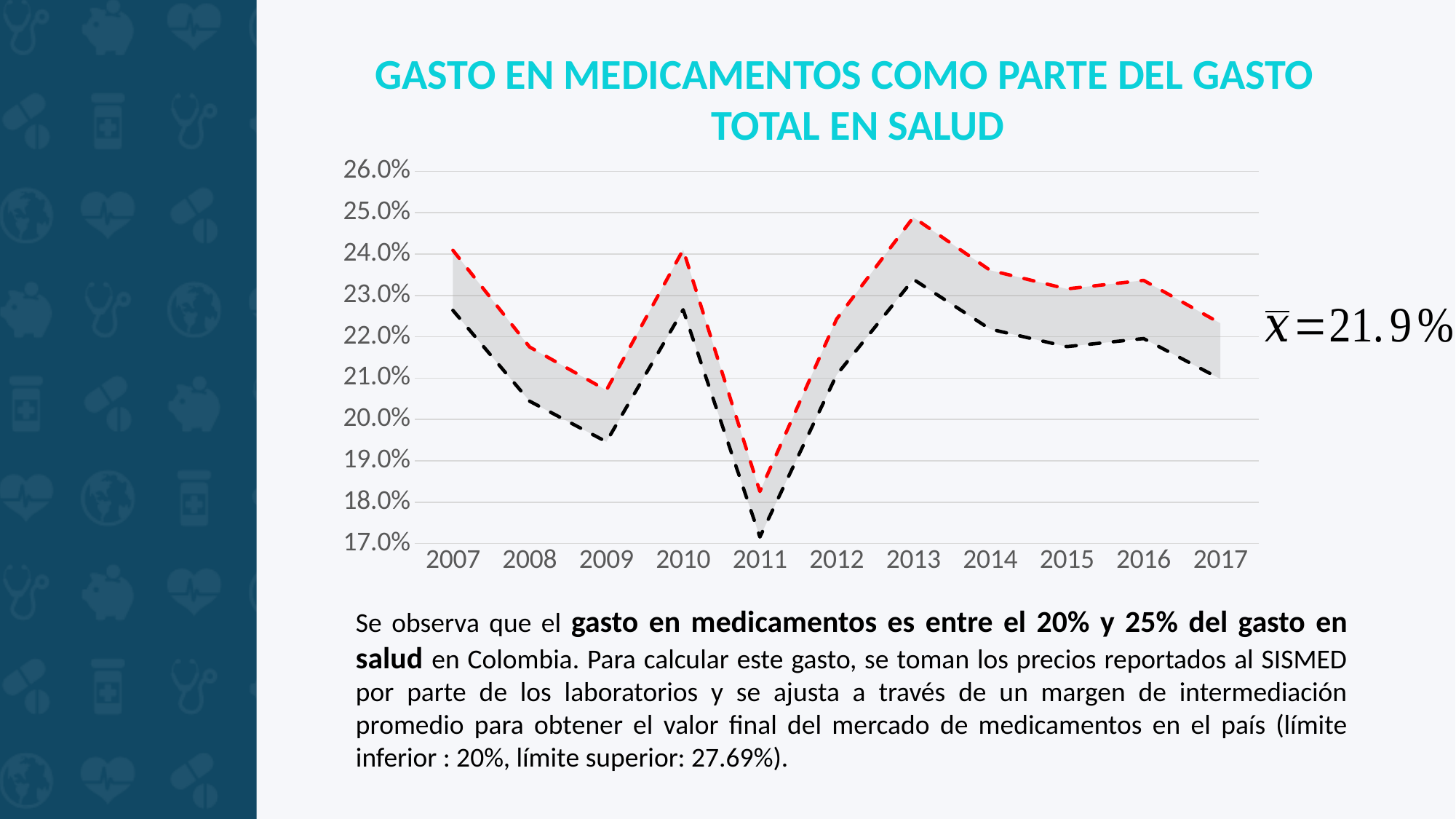
What kind of chart is shown on the slide? line chart Is the value of the upper (red dashed) line in 2013 greater or less than 24.0%? greater How many years are shown on the x axis of the chart? 11 What mean value (x̄) is annotated next to the chart? 21.9% Is the value of the lower (black dashed) line in 2009 greater or less than 20.0%? less In which year does the upper (red dashed) line reach its highest point? 2013 Is the value of the lower (black dashed) line in 2011 greater or less than 18.0%? less Which year has the higher value on the lower (black dashed) line, 2010 or 2011? 2010 In which year does the lower (black dashed) line reach its lowest point? 2011 Do the values of the upper (red dashed) line rise or fall from 2013 to 2017? fall What is the title of the chart? GASTO EN MEDICAMENTOS COMO PARTE DEL GASTO TOTAL EN SALUD